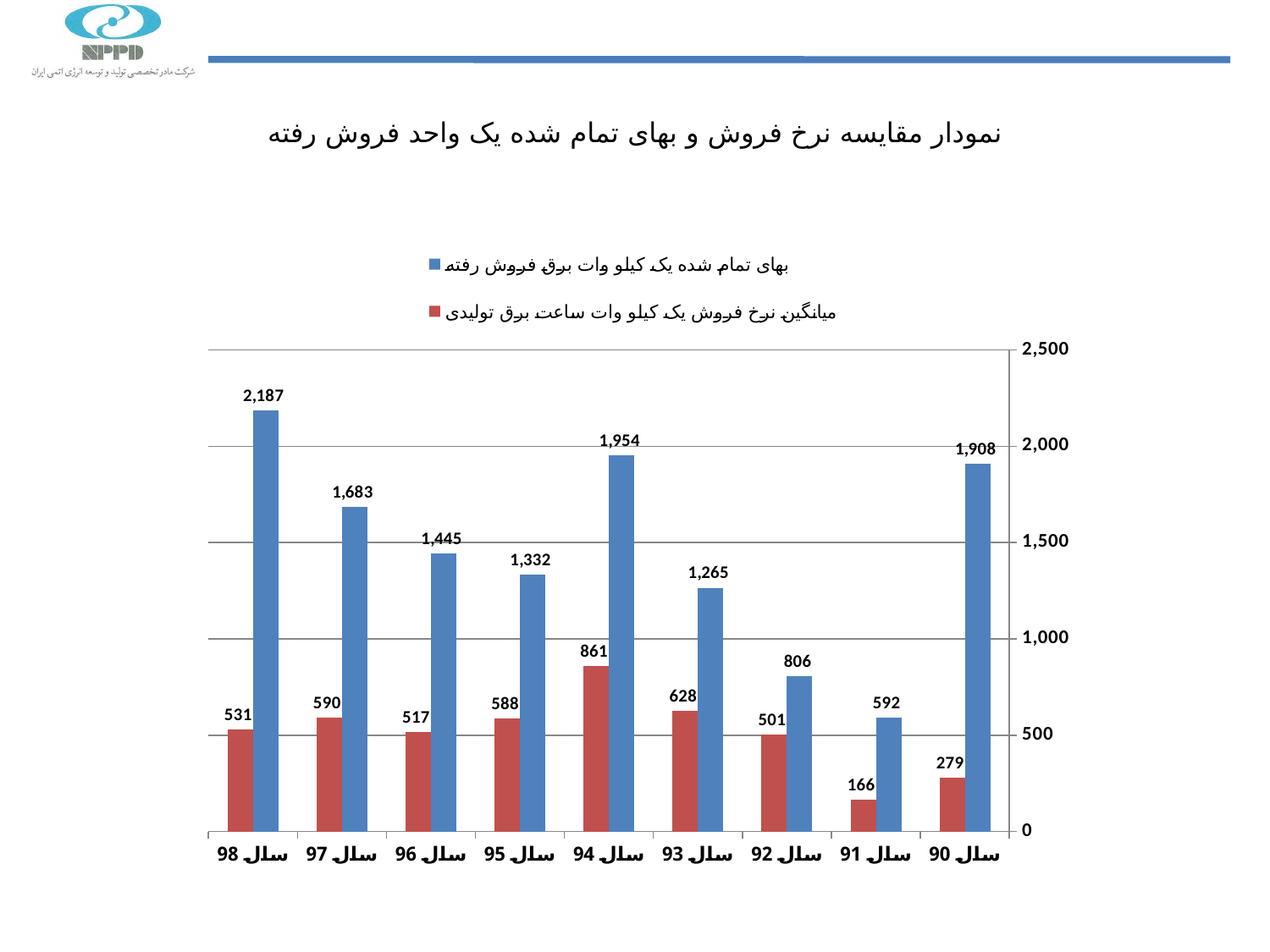
Which year has the lowest value in the red series (میانگین نرخ فروش)? سال 91 How many years (categories) are shown on the x axis? 9 How many series does the legend list? 2 What is the difference between the blue and red values for سال 90? 1,629 What is the maximum value shown on the vertical axis? 2,500 Which year has the highest value in the blue series (بهای تمام شده)? سال 98 Which is larger: the red series value for سال 97 or for سال 95? سال 97 What is the value of the blue series for سال 92? 806 What kind of chart is shown on the slide? bar chart What is the value of the red series (میانگین نرخ فروش یک کیلو وات ساعت برق تولیدی) for سال 94? 861 What is the value of the blue series (بهای تمام شده یک کیلو وات برق فروش رفته) for سال 98? 2,187 Is the blue series value for سال 91 greater or less than 500? greater